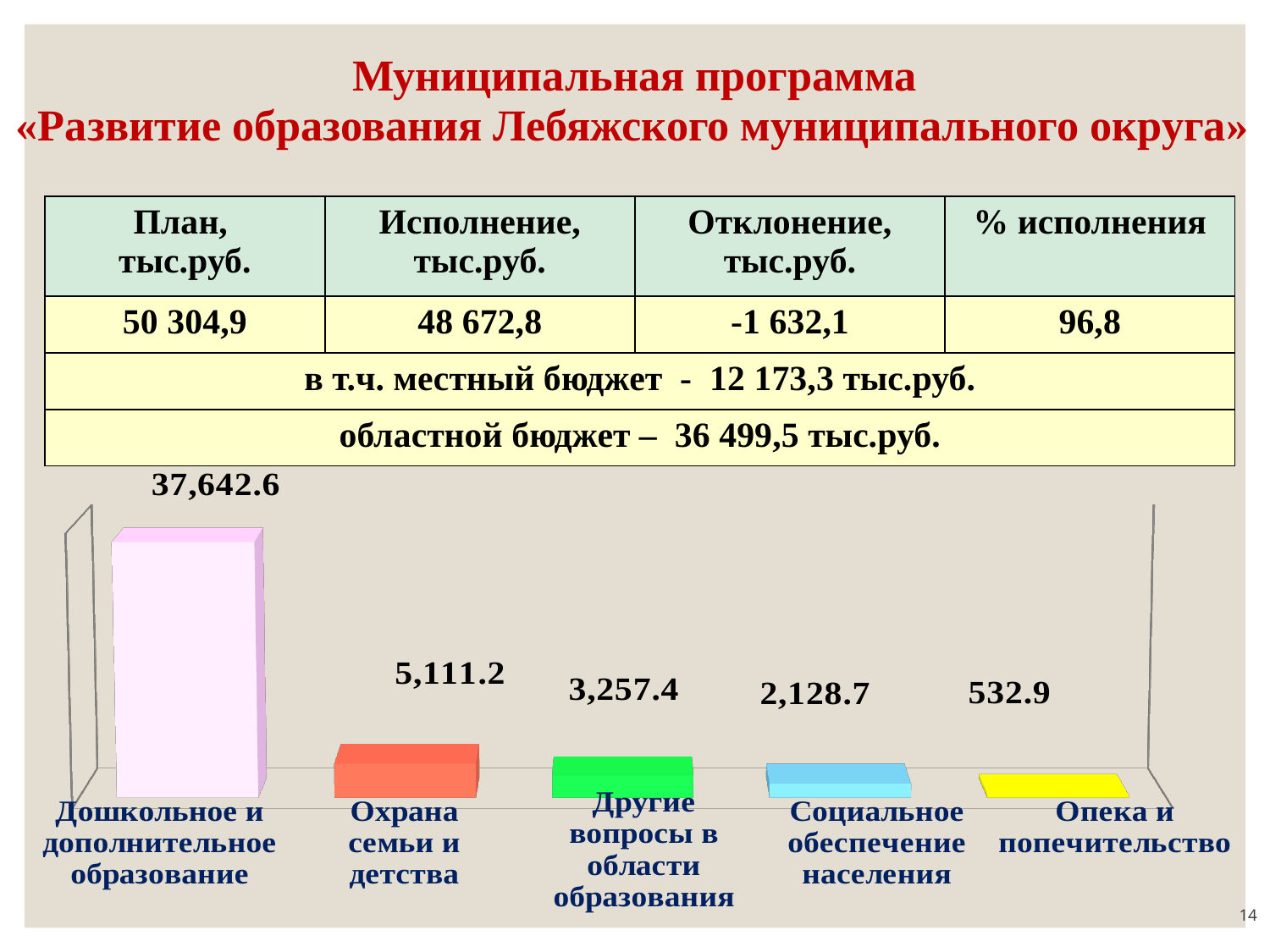
What is the difference between the values for Дошкольное и дополнительное образование and Охрана семьи и детства? 32,531.4 How many categories are shown in the chart? 5 What is the value for Социальное обеспечение населения? 2,128.7 Which category has the lowest value? Опека и попечительство What is the difference between the values for Социальное обеспечение населения and Опека и попечительство? 1,595.8 What is the value for Опека и попечительство? 532.9 Which is larger: the value for Охрана семьи и детства or the value for Другие вопросы в области образования? Охрана семьи и детства What is the value for Дошкольное и дополнительное образование? 37,642.6 What is the value for Охрана семьи и детства? 5,111.2 What is the value for Другие вопросы в области образования? 3,257.4 What kind of chart is shown on the slide? Bar chart Which category has the highest value? Дошкольное и дополнительное образование